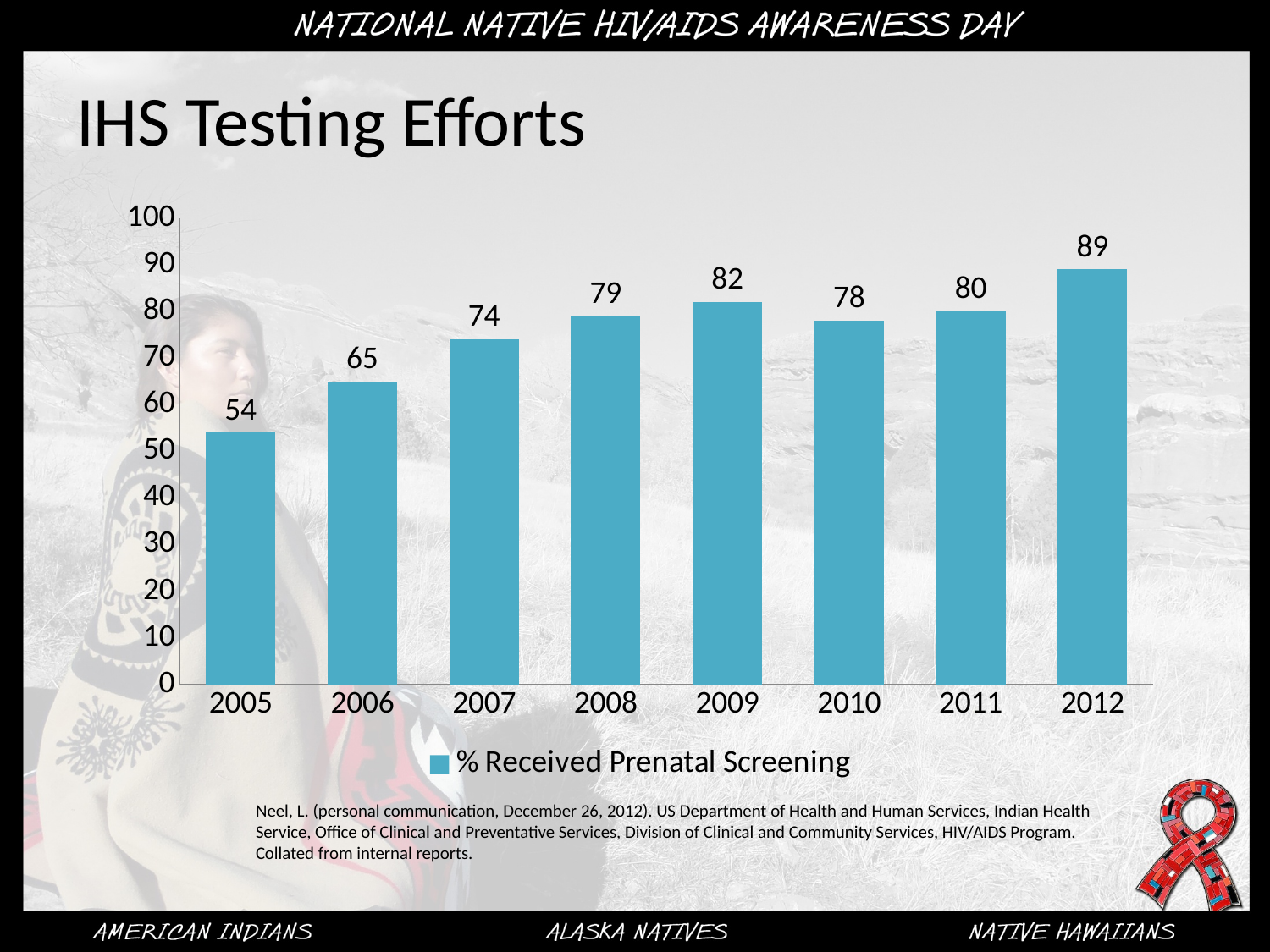
What kind of chart is shown? bar chart Is the value for 2006 greater or less than 70? less Which is larger, the value for 2009 or the value for 2010? 2009 What is the series name shown in the legend? % Received Prenatal Screening Which year has the highest value? 2012 What is the value for 2009? 82 What is the value for 2012? 89 How many series does the legend list? 1 What is the difference between the values for 2012 and 2005? 35 What is the value for 2005? 54 Which year has the lowest value? 2005 How many years are shown on the x axis? 8